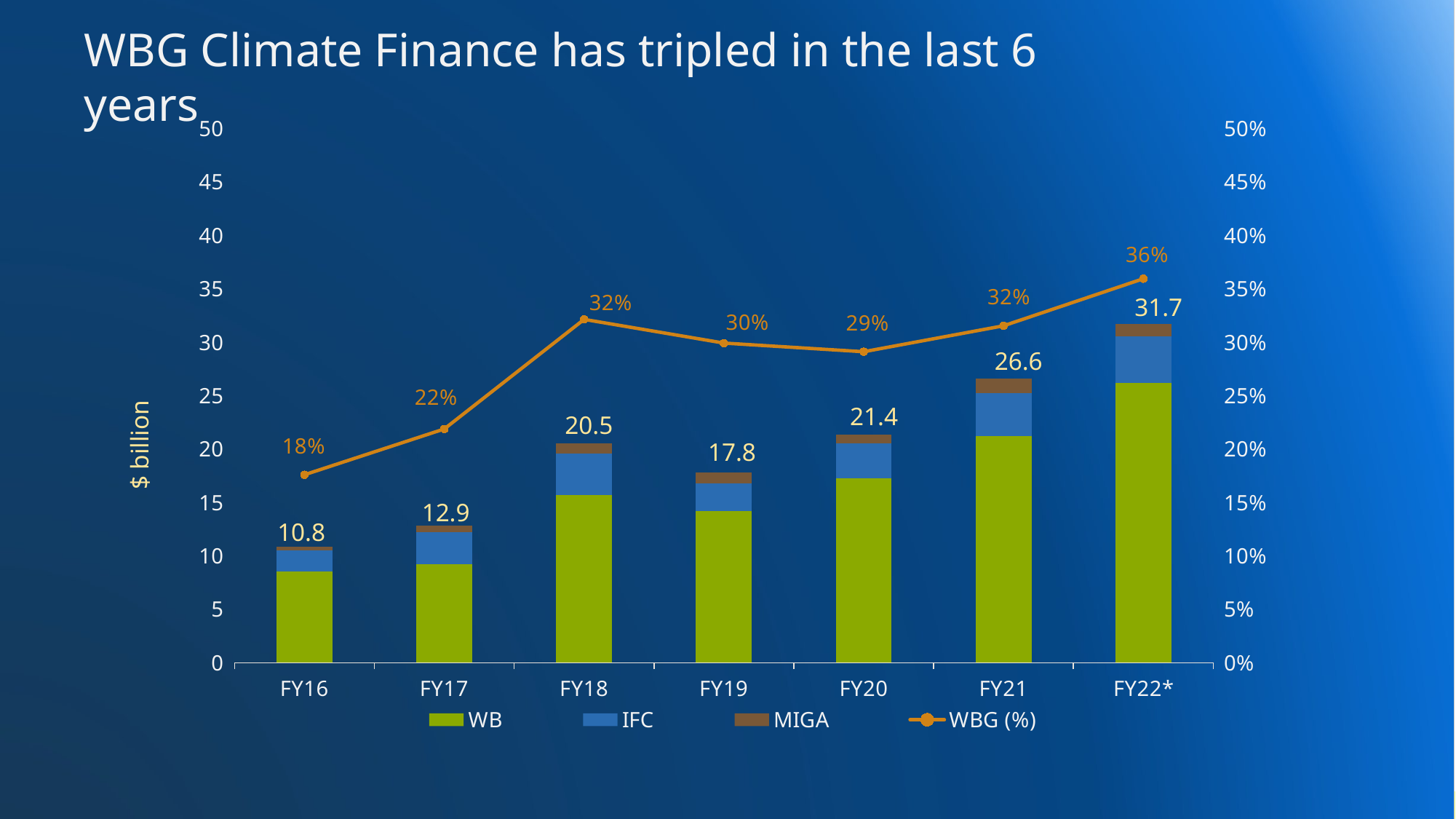
Is the WB segment of the FY22* bar greater or less than 25? greater What is the total climate finance value labelled for FY20? 21.4 Does the WBG (%) line rise or fall from FY16 to FY18? rise Which fiscal year has the highest total climate finance bar? FY22* Which has the larger total climate finance, FY18 or FY19? FY18 What kind of chart is shown on the slide? Stacked bar chart with a line What is the label on the left vertical axis? $ billion What is the difference between the total labelled for FY22* and the total labelled for FY16? 20.9 Which fiscal year has the lowest WBG (%) value? FY16 How many series does the legend list? 4 How many fiscal years are shown on the x axis? 7 What is the WBG (%) value shown for FY19? 30%